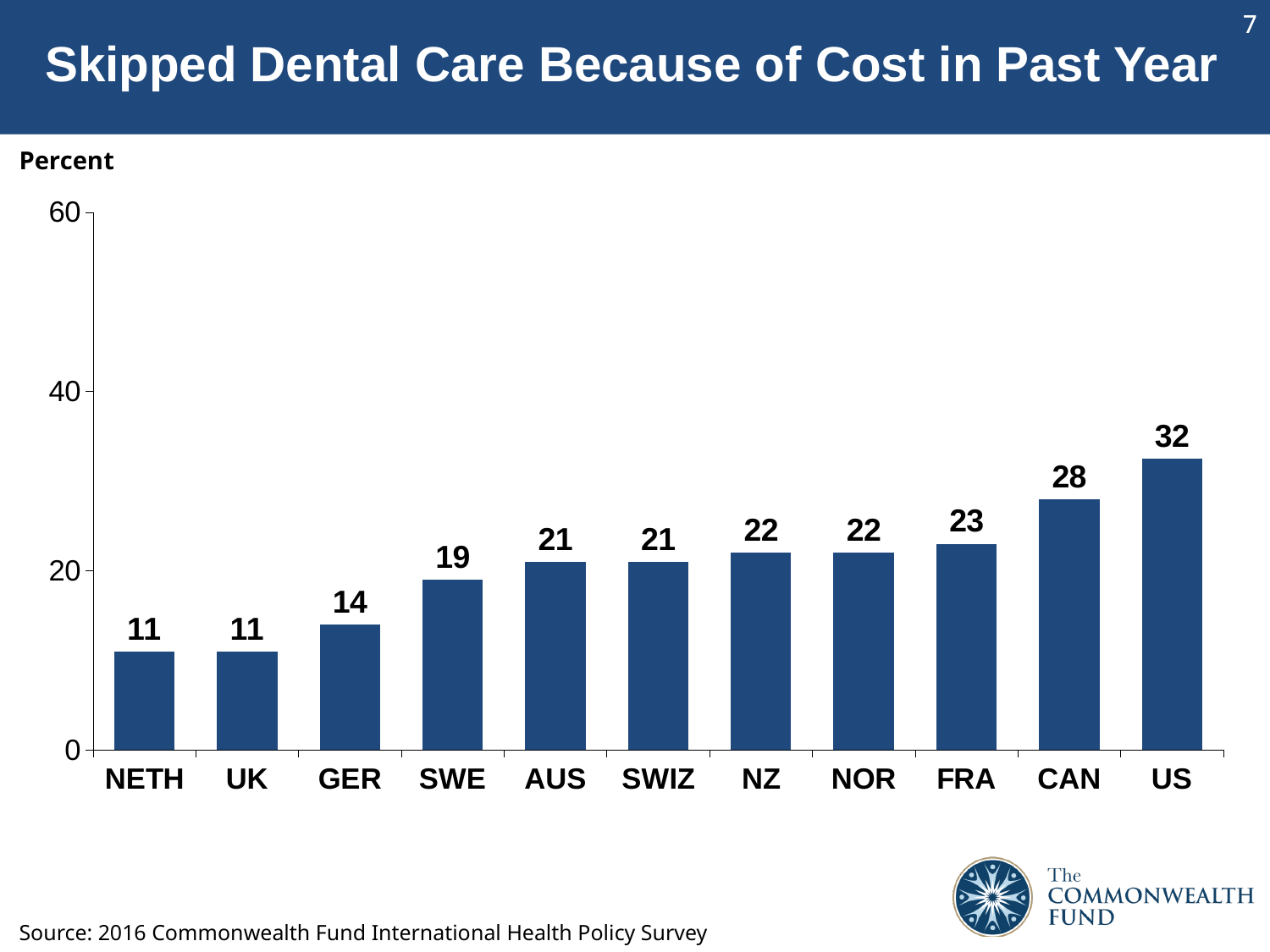
What kind of chart is shown on the slide? Bar chart Which country has the highest value? US What is the difference between the values for the US and CAN? 4 How many countries are shown on the chart? 11 Do the values generally rise or fall from left to right across the countries? Rise What is the value for GER? 14 Which is larger, the value for CAN or the value for FRA? CAN What is the difference between the values for SWE and NETH? 8 What is the value for FRA? 23 Is the value for CAN greater or less than 20? greater Which country has the lowest value, NETH or GER? NETH What is the value for the US? 32